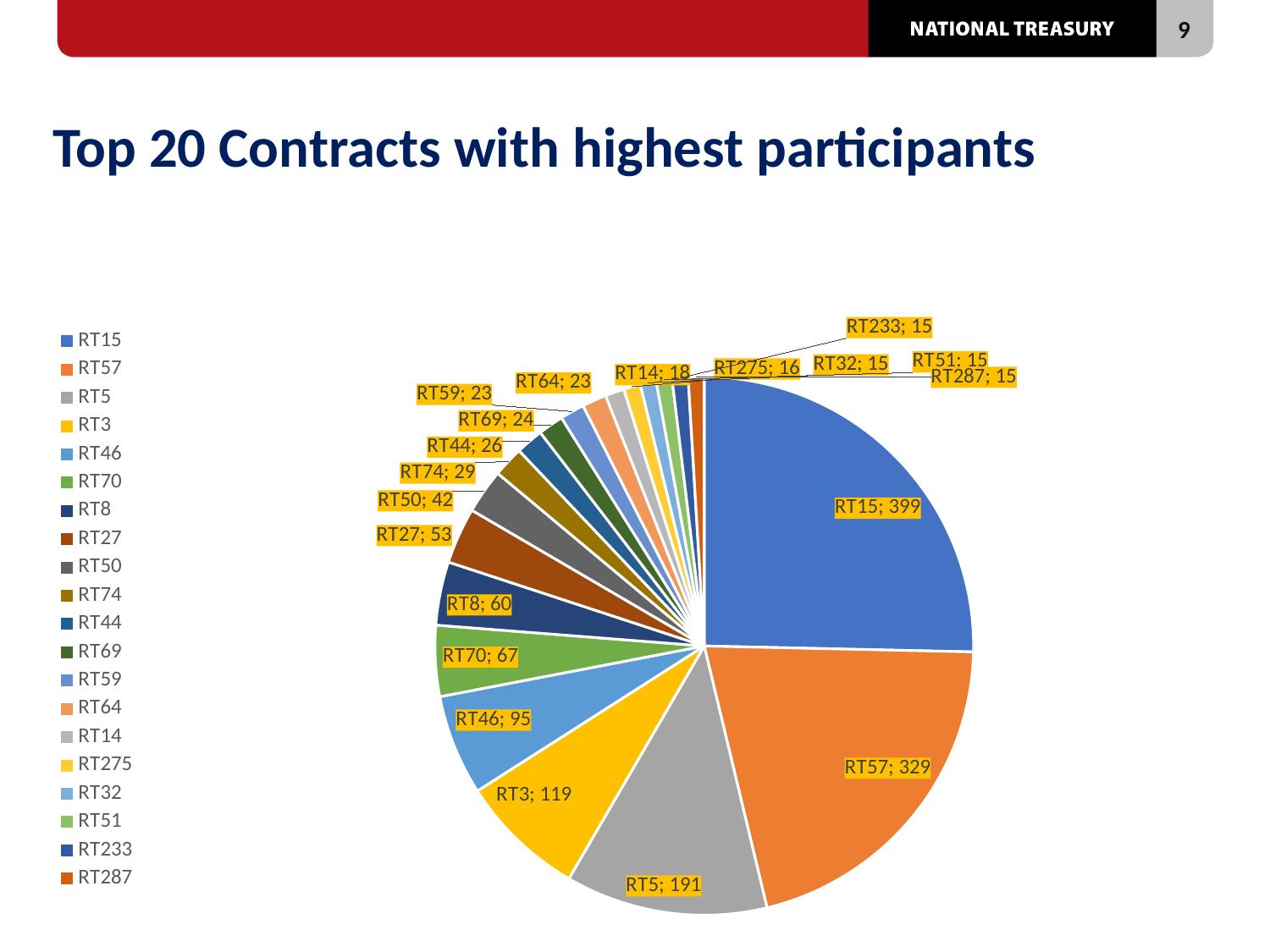
How many contracts (slices) are shown in the pie chart? 20 What is the value shown for RT74? 29 What is the difference between the values for RT15 and RT57? 70 What colour is the slice for RT57? Orange What is the value shown for RT46? 95 Which contract has the highest number of participants? RT15 Which has a larger value, RT70 or RT8? RT70 What is the difference between the values for RT5 and RT3? 72 What is the value shown for RT57? 329 How many participants does contract RT15 have? 399 What is the title of the slide? Top 20 Contracts with highest participants What type of chart is shown on the slide? Pie chart